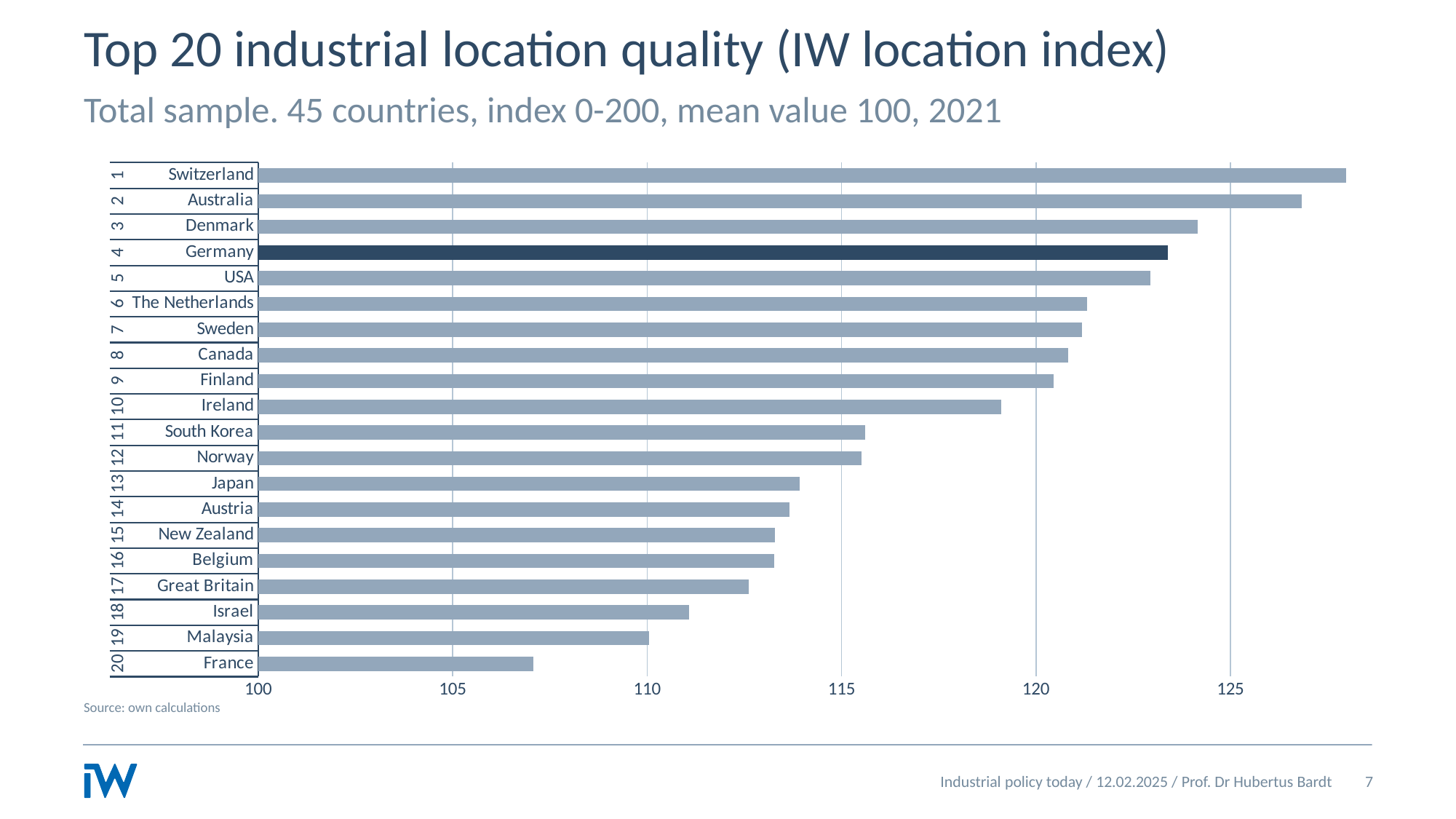
Which country's bar is highlighted in a darker colour than the others? Germany Is the value for France greater or less than 110? less Is the value for Germany greater or less than 120? greater Is the value for Ireland greater or less than 120? less Which country has the highest value in the chart? Switzerland What kind of chart is shown on the slide? bar chart Do the bar values rise or fall going from the top of the chart to the bottom? fall Which country has the lowest value in the chart? France How many countries are shown in the chart? 20 Which has the larger value, Denmark or Ireland? Denmark